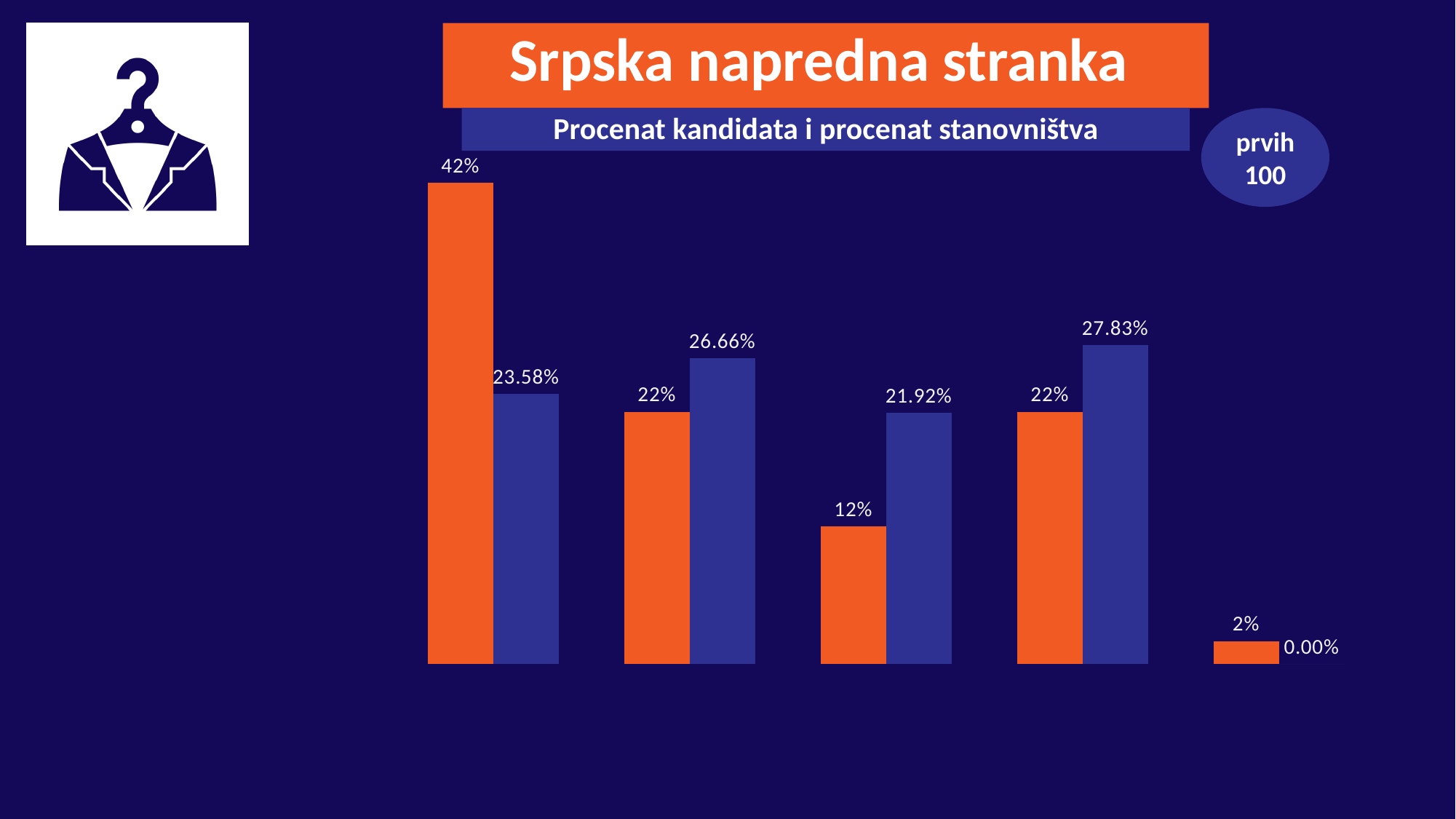
What is the value of the orange bar in the leftmost group? 42% What is the highest value among the orange bars? 42% What is the lowest value among the orange bars? 2% What is the value of the blue bar in the rightmost group? 0.00% What is the value of the blue bar in the third group from the left? 21.92% In the leftmost group, how much larger is the orange bar than the blue bar? 18.42% What is the highest value among the blue bars? 27.83% In the second group from the left, which bar is larger, the orange one or the blue one? the blue one What is the value of the blue bar in the leftmost group? 23.58% What kind of chart is shown on the slide? bar chart What is the title shown in the orange banner above the chart? Srpska napredna stranka How many groups of bars are plotted in the chart? 5